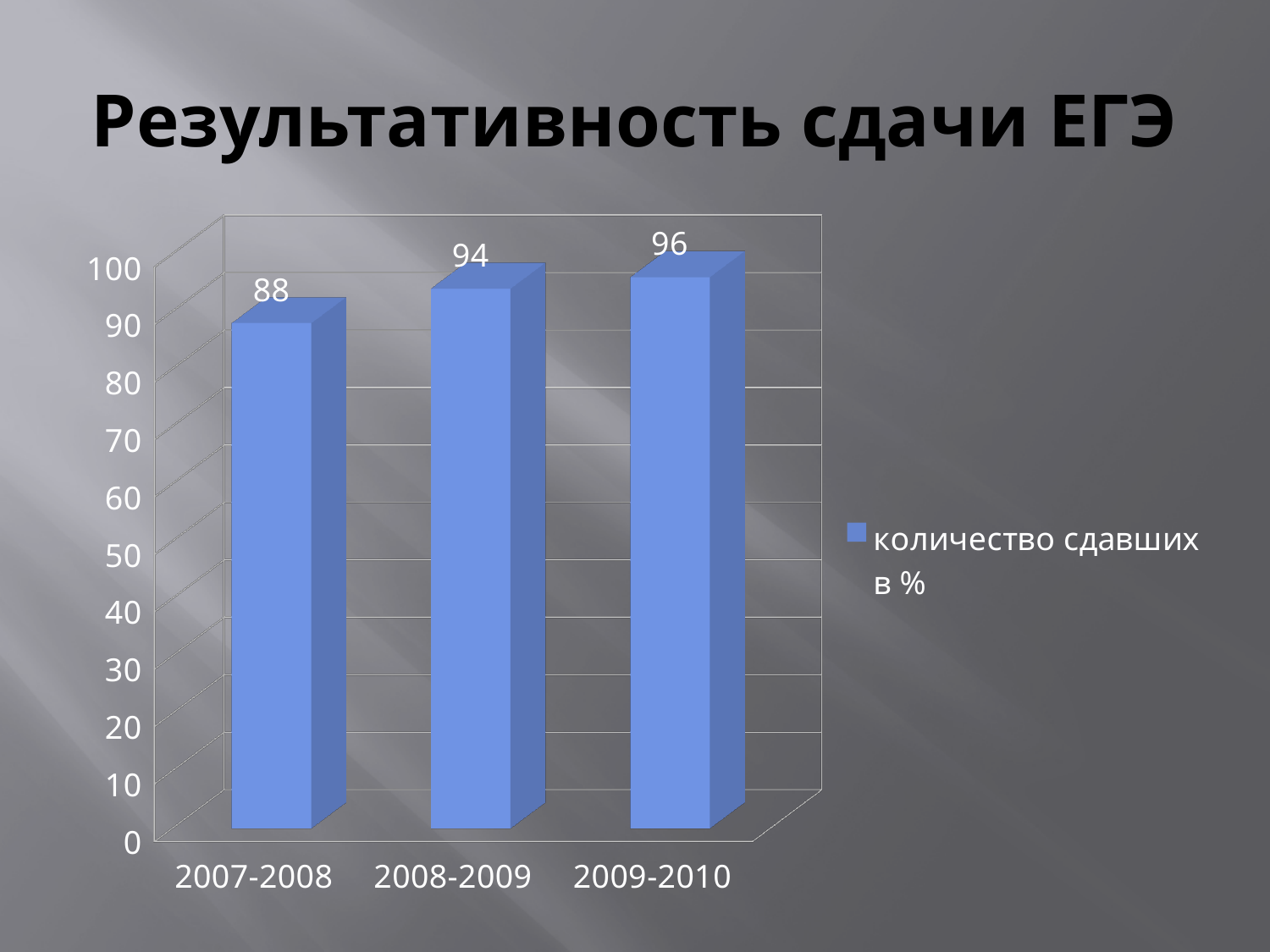
Do the values rise or fall from 2007-2008 to 2009-2010? rise What is the value for 2008-2009? 94 What is the difference between the values for 2008-2009 and 2007-2008? 6 Which category has the highest value? 2009-2010 What kind of chart is shown on the slide? bar chart How many categories are shown on the x axis? 3 Is the value for 2007-2008 greater or less than 90? less Which is larger, the value for 2008-2009 or the value for 2007-2008? 2008-2009 What is the value for 2009-2010? 96 What is the value for 2007-2008? 88 Which category has the lowest value? 2007-2008 What is the difference between the values for 2009-2010 and 2007-2008? 8